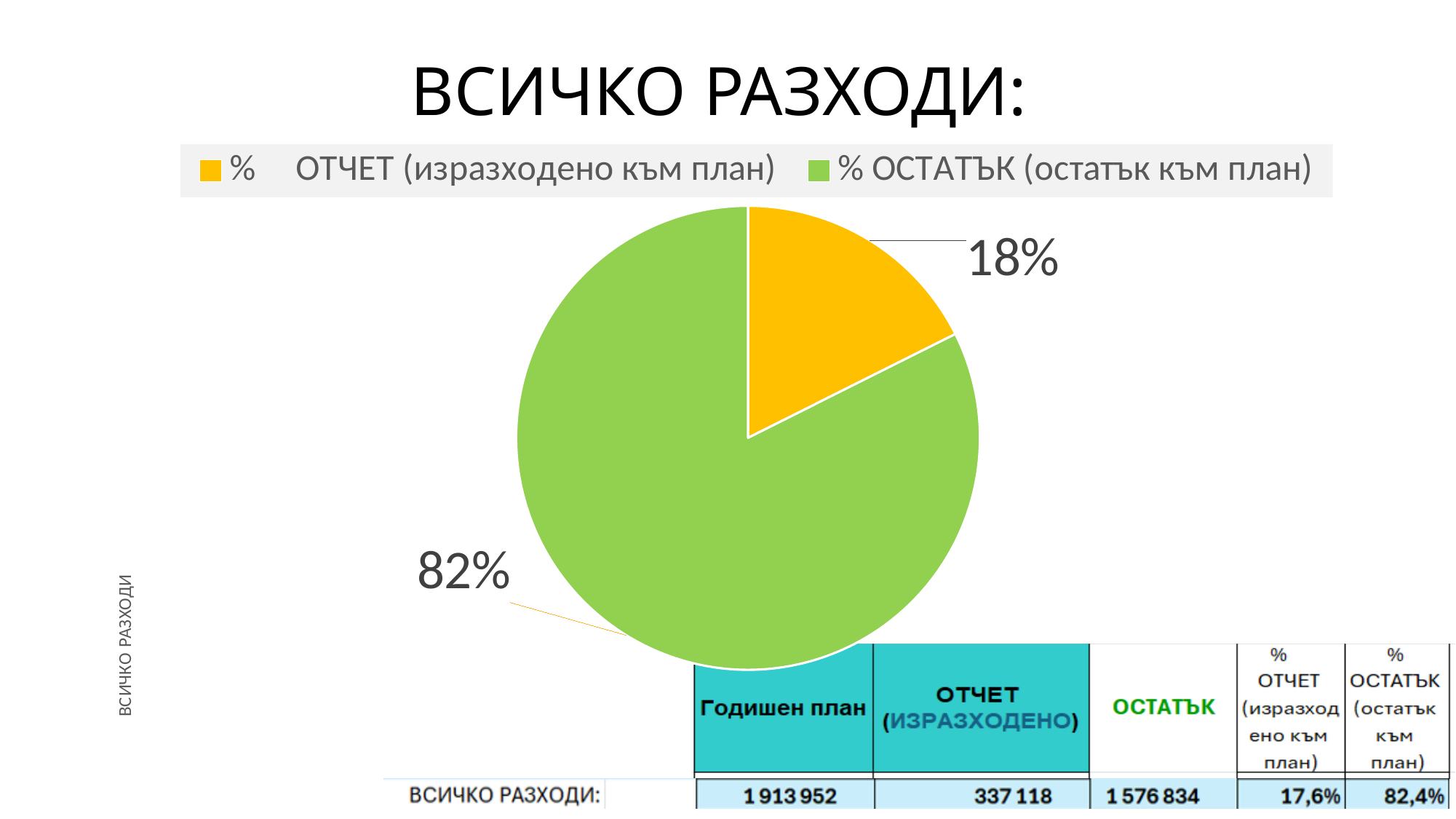
Which is larger, the % ОТЧЕТ slice or the % ОСТАТЪК slice? % ОСТАТЪК What colour is the % ОТЧЕТ (изразходено към план) slice? yellow What type of chart is shown on the slide? pie chart What is the total of the two pie slice percentages? 100% What is the difference in percentage points between the % ОСТАТЪК slice and the % ОТЧЕТ slice? 64 How many entries does the legend list? 2 What share of the pie is labelled for % ОСТАТЪК (остатък към план)? 82% Which slice of the pie is the smallest? % ОТЧЕТ (изразходено към план) Which slice of the pie is the largest? % ОСТАТЪК (остатък към план) How many slices does the pie chart have? 2 What share of the pie is labelled for % ОТЧЕТ (изразходено към план)? 18% What is the title of the chart? ВСИЧКО РАЗХОДИ: